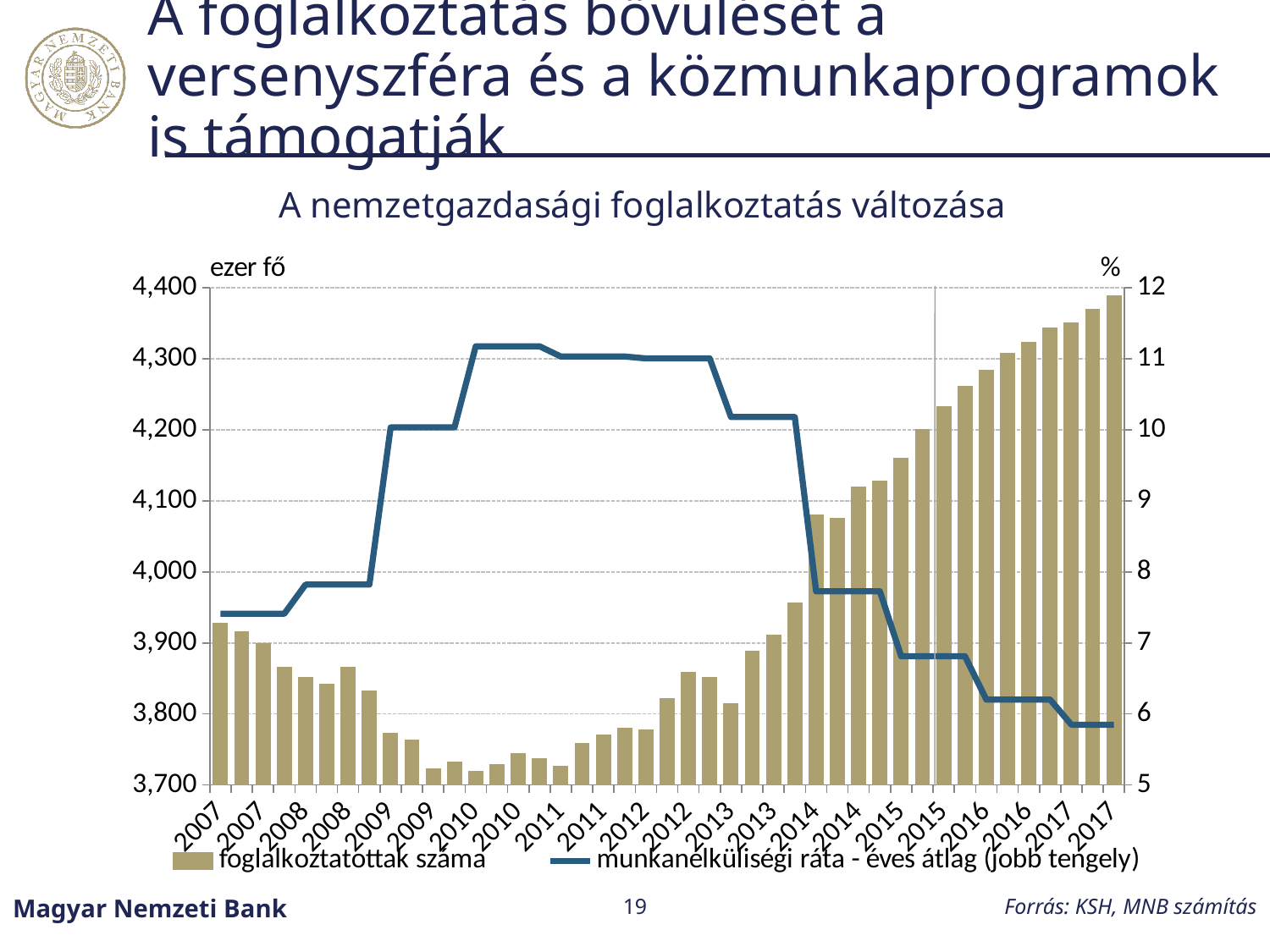
In which year is the unemployment rate (munkanélküliségi ráta) lowest? 2017 Is the number of employed in the first bar of 2007 greater or less than 3,900 thousand? greater Which is larger, the unemployment rate in 2010 or in 2017? 2010 In which year is the number of employed (foglalkoztatottak száma) highest? 2017 Is the unemployment rate in 2010 greater or less than 10%? greater Is the number of employed in the last bar of 2017 greater or less than 4,300 thousand? greater How many series does the legend list? 2 Does the number of employed rise or fall from 2013 to 2017? rise What kind of chart is shown on the slide? A combined bar and line chart Which series is plotted on the right axis according to the legend? munkanélküliségi ráta - éves átlag (jobb tengely) What is the title of the chart? A nemzetgazdasági foglalkoztatás változása